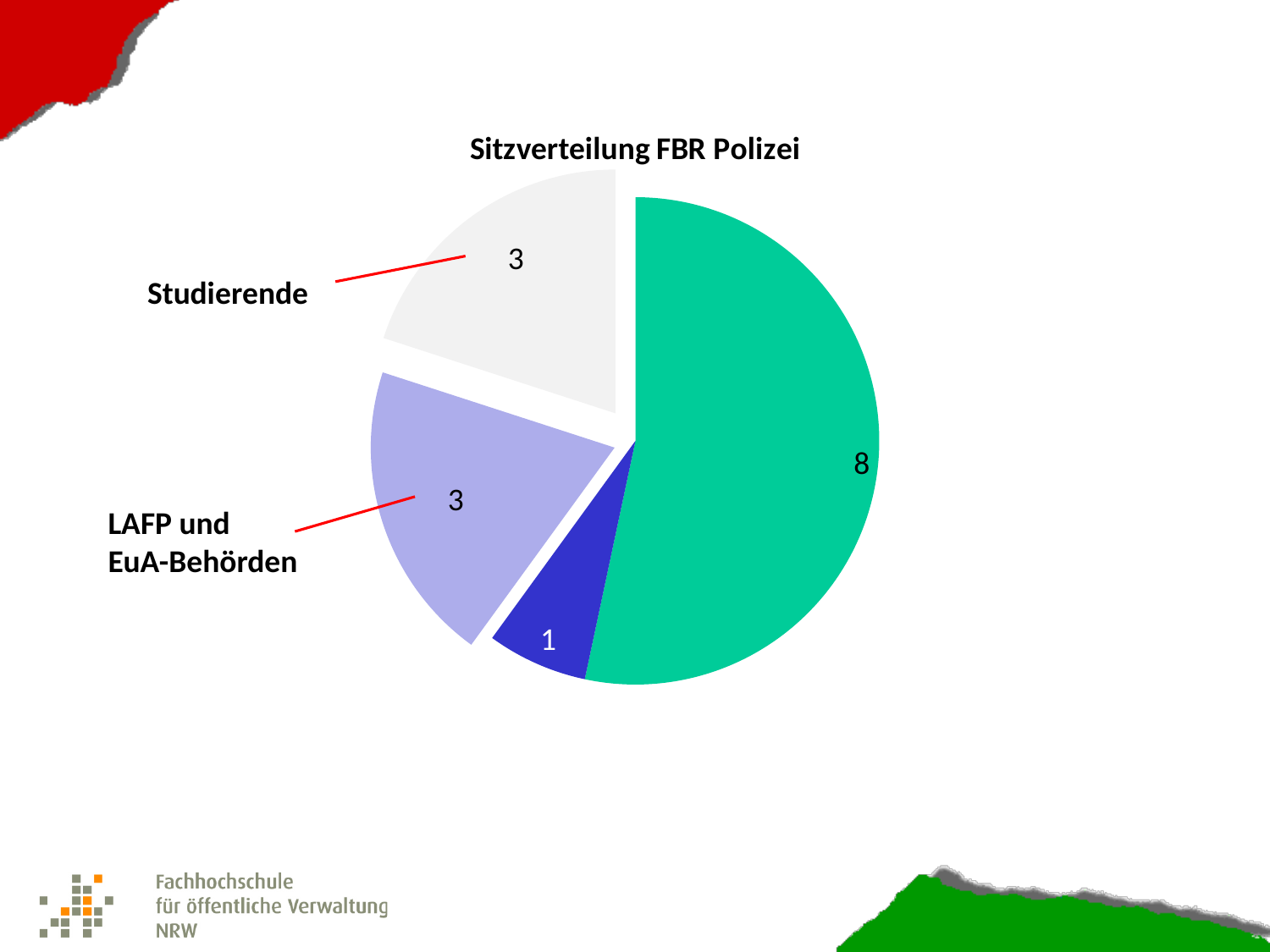
What is the title of the chart? Sitzverteilung FBR Polizei How many seats does the Studierende slice show? 3 What is the total number of seats shown across all slices of the pie chart? 15 How many seats does the LAFP und EuA-Behörden slice show? 3 What kind of chart is shown on the slide? pie chart What share of the total seats does the Studierende slice represent? 20% What is the difference between the largest slice and the Studierende slice? 5 Is the largest slice greater or less than half of the total seats? greater What is the value of the smallest slice in the pie chart? 1 What colour is the largest slice of the pie chart? green How many slices does the pie chart have? 4 What is the value of the largest slice in the pie chart? 8